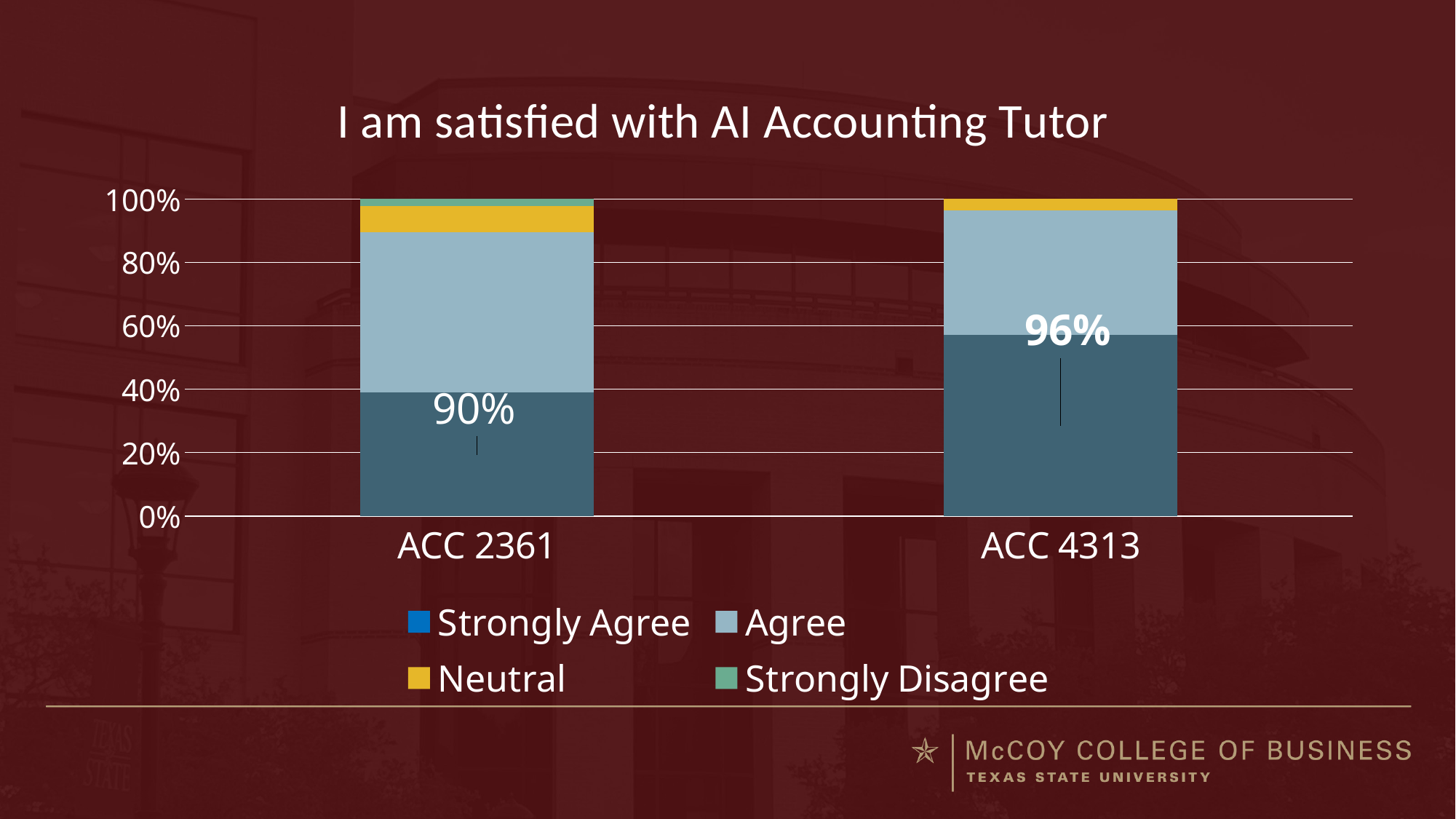
Is the Strongly Agree share for ACC 2361 greater or less than 60%? less What percentage label is printed on the ACC 2361 bar? 90% What is the title of the chart? I am satisfied with AI Accounting Tutor What percentage label is printed on the ACC 4313 bar? 96% Is the Strongly Agree share for ACC 4313 greater or less than 40%? greater How many series does the legend list? 4 What kind of chart is shown on the slide? stacked bar chart Which course has the higher percentage label printed on its bar? ACC 4313 How many courses (categories) are shown on the x axis? 2 Which legend entry is shown in yellow? Neutral Which course has the larger Strongly Agree segment, ACC 2361 or ACC 4313? ACC 4313 What is the difference between the percentage labels printed on the ACC 4313 and ACC 2361 bars? 6 percentage points